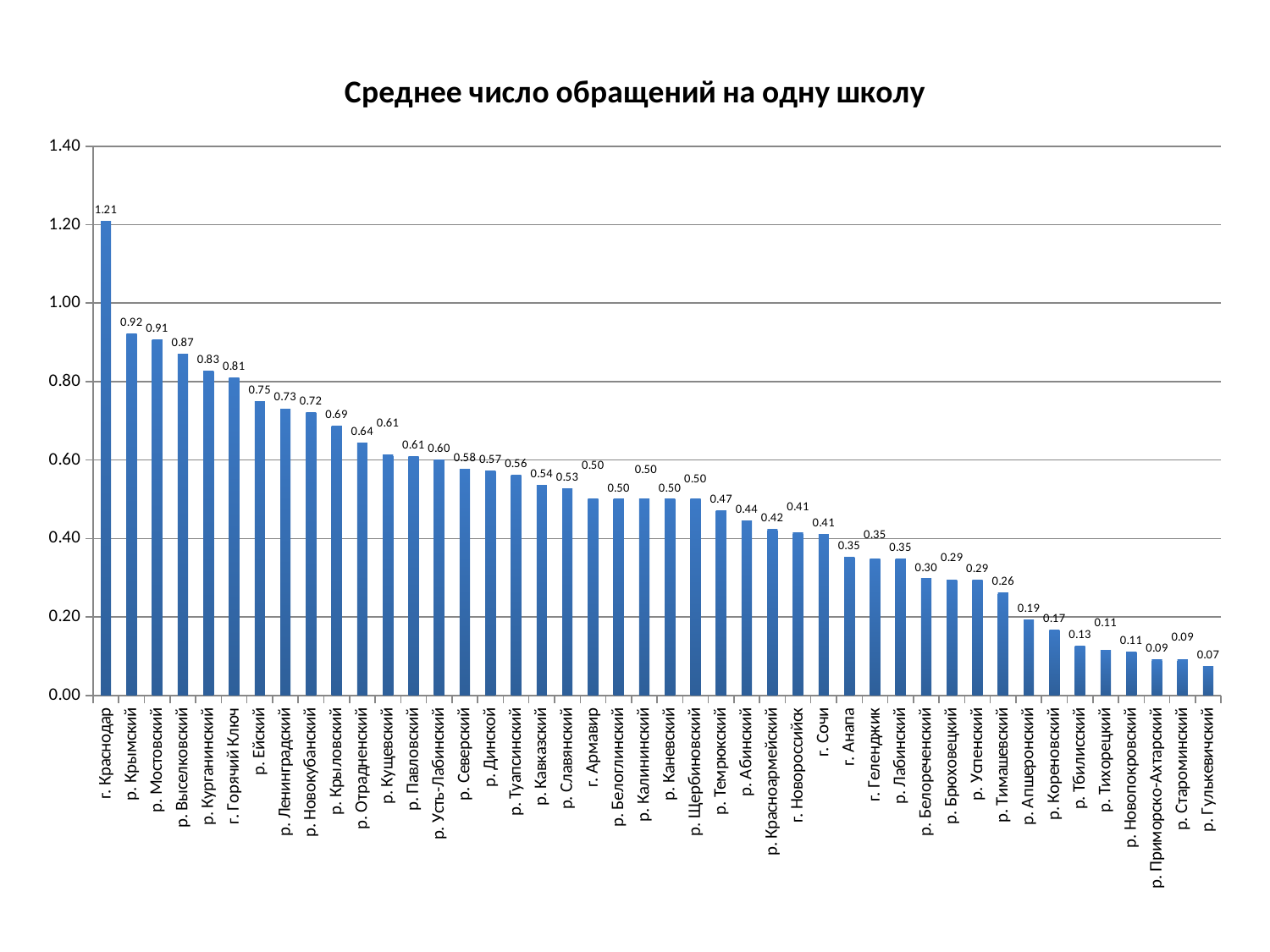
What is the value for р. Ейский? 0.75 What is the value for г. Сочи? 0.41 Do the values generally rise or fall from left to right along the x axis? fall What is the difference between the values for г. Краснодар and р. Крымский? 0.29 What is the title of the chart? Среднее число обращений на одну школу What is the value for р. Тимашевский? 0.26 What is the value for г. Краснодар? 1.21 Is the value for р. Отрадненский greater or less than 0.60? greater Which is larger, the value for р. Мостовский or the value for р. Курганинский? р. Мостовский What type of chart is shown on the slide? bar chart Which category has the lowest value? р. Гулькевичский Which category has the highest value? г. Краснодар